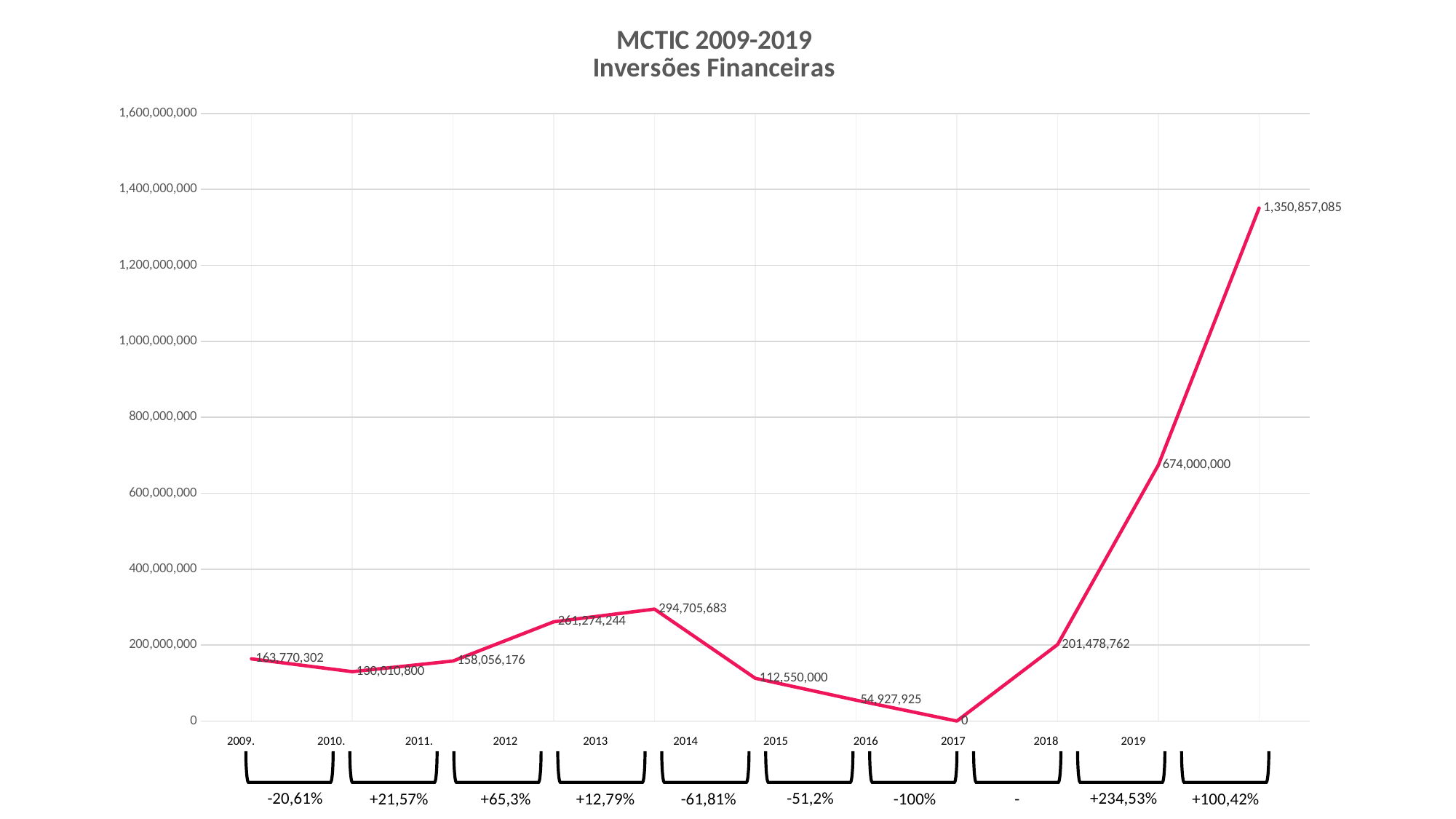
How many data points are plotted on the line? 11 Which is larger, the value for 2012 or the value for 2014? 2012 What kind of chart is shown on the slide? Line chart What is the value for 2009? 163,770,302 Do the values rise or fall from 2016 to 2019? Rise What is the difference between the values for 2019 and 2018? 676,857,085 Which year has the highest value? 2019 What is the value for 2013? 294,705,683 Which year has the lowest value? 2016 What is the title of the chart? MCTIC 2009-2019 Inversões Financeiras Is the value for 2019 greater or less than 1,200,000,000? greater What is the value for 2018? 674,000,000